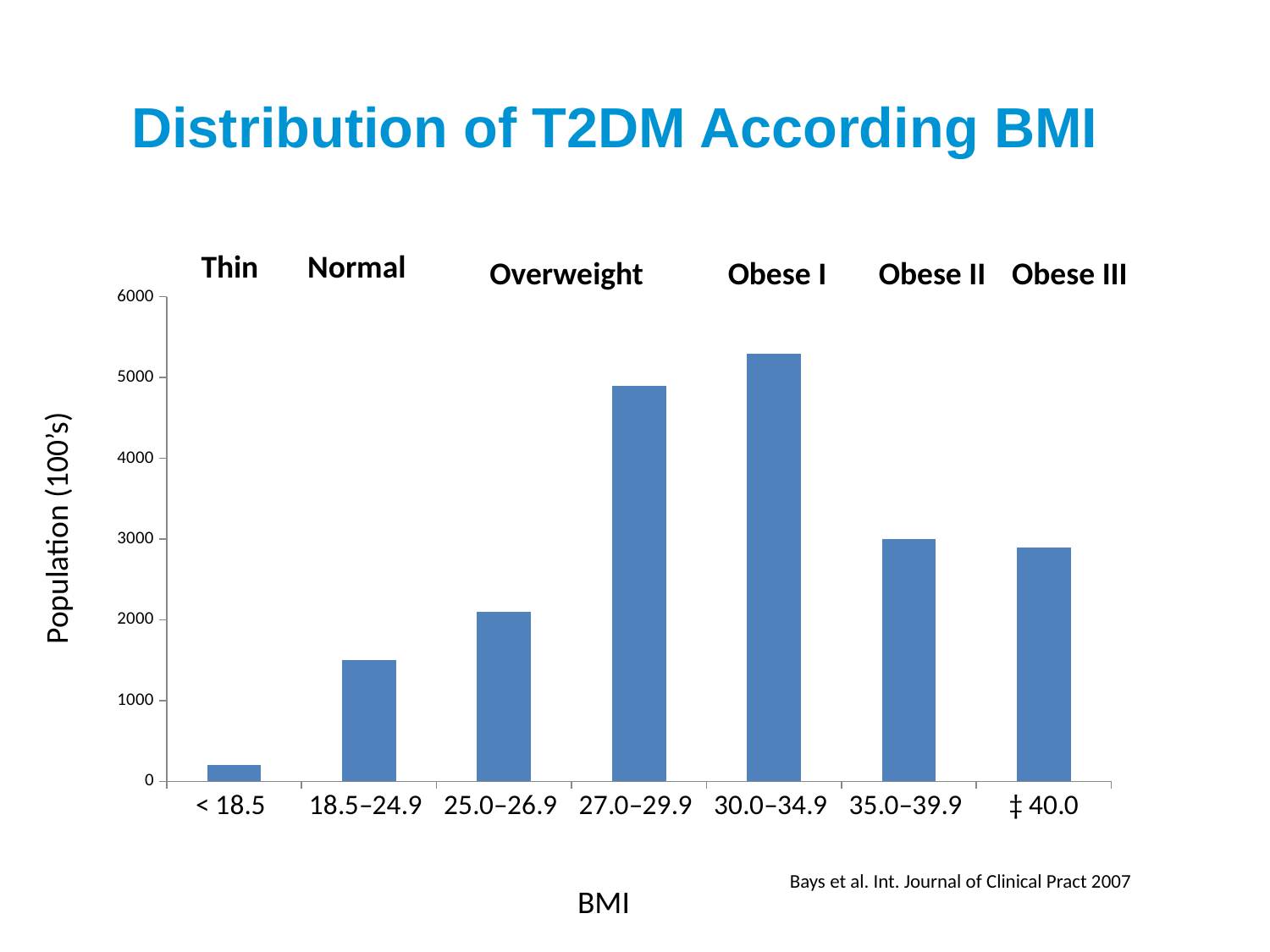
What kind of chart is shown on the slide? bar chart Is the value for the 27.0–29.9 BMI category greater or less than 4000? greater Is the value for the 18.5–24.9 BMI category greater or less than 1000? greater Is the value for the 25.0–26.9 BMI category greater or less than 3000? less How many BMI categories are plotted in the chart? 7 Which has a larger population, the 27.0–29.9 category or the 18.5–24.9 category? 27.0–29.9 What is the label of the vertical axis? Population (100's) Which BMI category has the highest population? 30.0–34.9 Which BMI category has the lowest population? < 18.5 Do the values rise or fall from the 30.0–34.9 category to the ‡ 40.0 category? fall